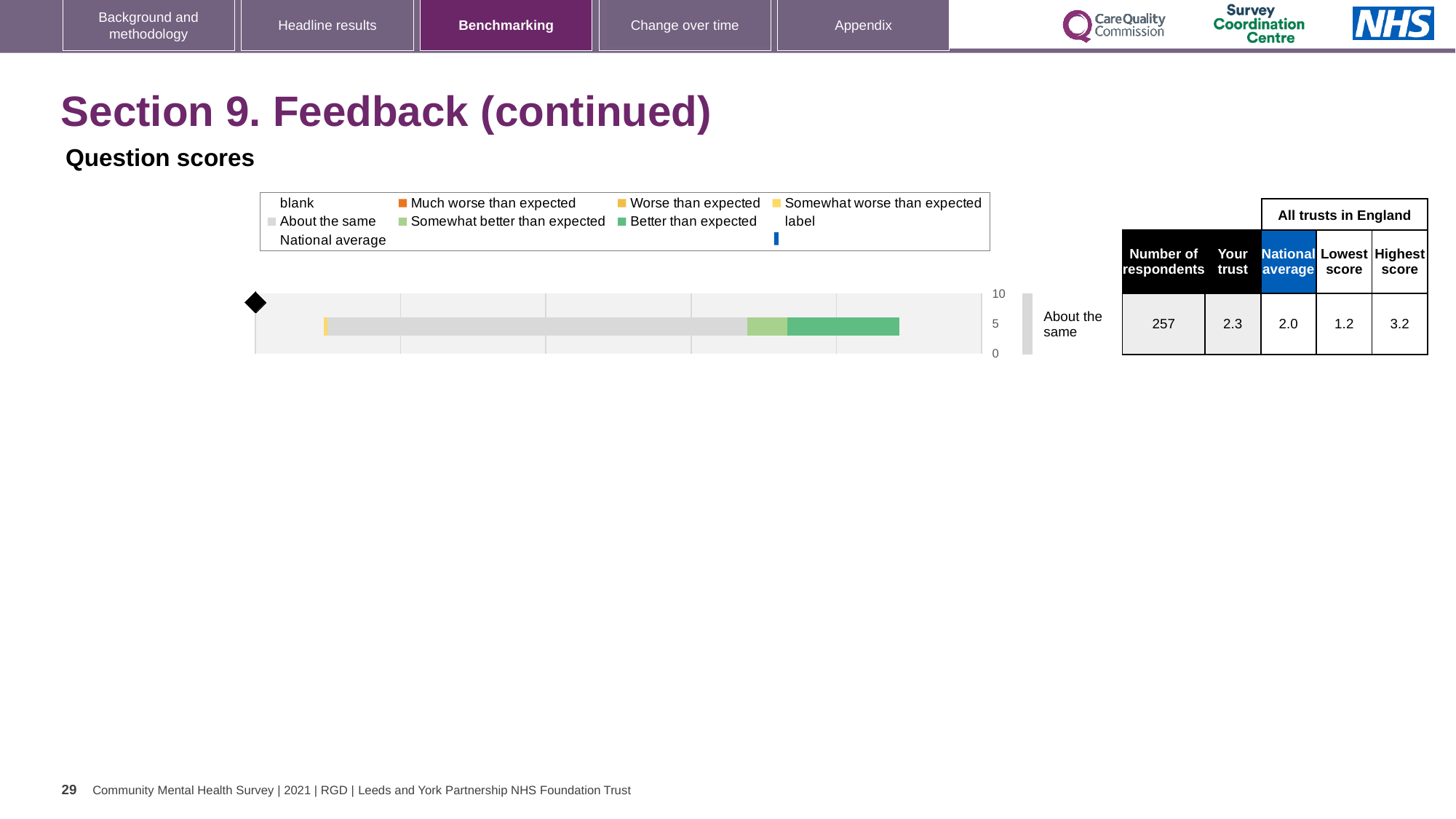
What is the 'Your trust' score shown in the table for this question? 2.3 What is the difference between the 'Your trust' score and the national average? 0.3 What kind of chart is shown on the slide? bar chart What is the number of respondents shown in the table? 257 How many bars does the chart contain? 1 What colour does the legend use for 'Better than expected'? green Which is larger, the 'Your trust' score or the national average? Your trust What is the national average score shown in the table? 2.0 What is the highest score among all trusts in England shown in the table? 3.2 What is the difference between the highest score and the lowest score in the table? 2.0 What is the lowest score among all trusts in England shown in the table? 1.2 What category label is shown next to the bar in the chart? About the same